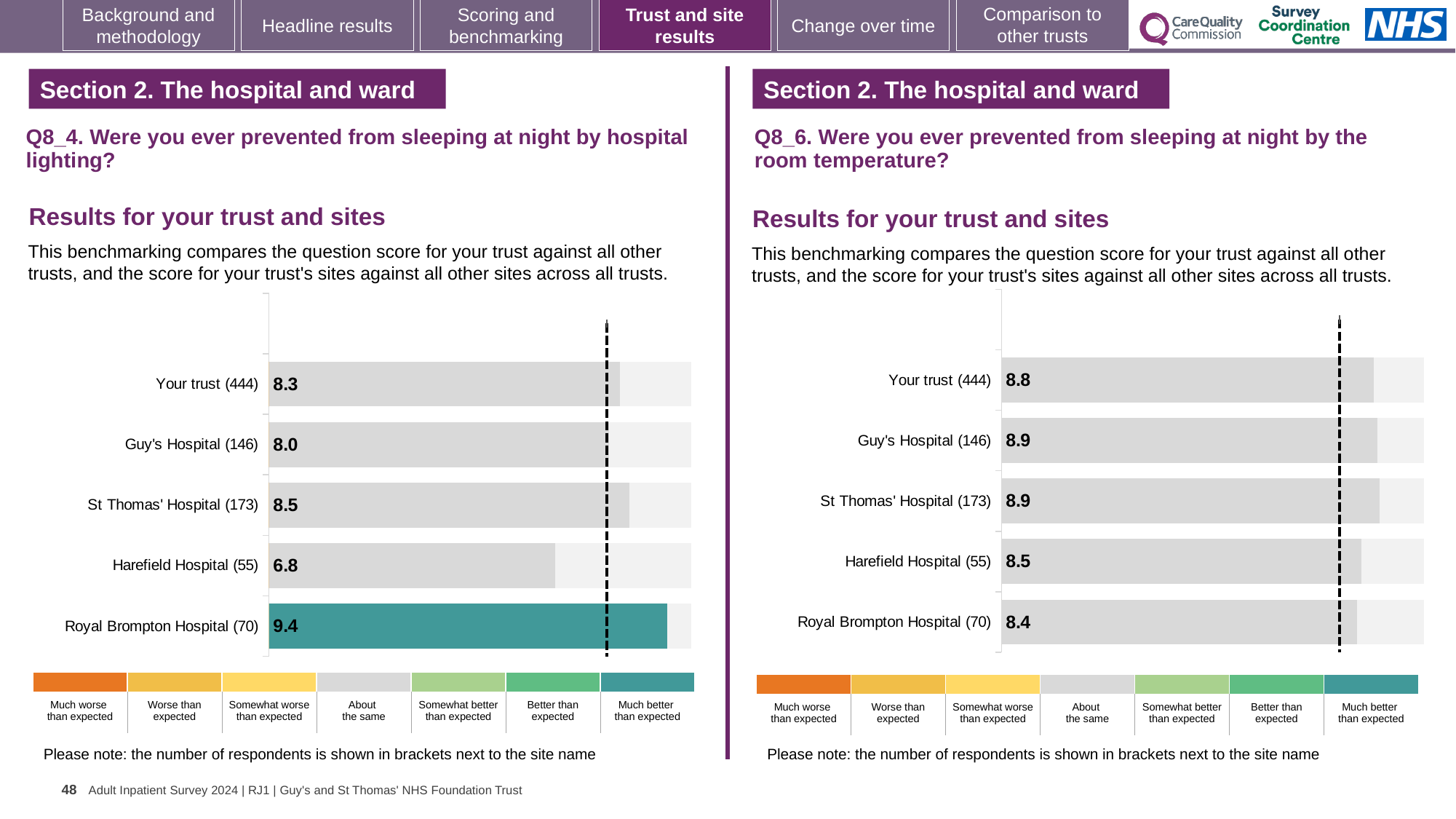
In the Q8_6 chart (room temperature), what is the score for Royal Brompton Hospital? 8.4 In the Q8_6 chart (room temperature), what is the difference between the scores for Guy's Hospital and Harefield Hospital? 0.4 In the Q8_6 chart (room temperature), what is the score for Your trust? 8.8 What kind of chart is used for the Q8_6 results (room temperature)? Bar chart In the Q8_6 chart (room temperature), which is larger: the score for Harefield Hospital or the score for Royal Brompton Hospital? Harefield Hospital In the Q8_6 chart (room temperature), which site has the lowest score? Royal Brompton Hospital In the Q8_4 chart (hospital lighting), which site or trust row has the highest score? Royal Brompton Hospital In the Q8_4 chart (hospital lighting), what is the score for Harefield Hospital? 6.8 In the Q8_4 chart (hospital lighting), what is the score for Royal Brompton Hospital? 9.4 In the Q8_4 chart (hospital lighting), which site or trust row has the lowest score? Harefield Hospital In the Q8_4 chart (hospital lighting), what is the difference between the scores for St Thomas' Hospital and Guy's Hospital? 0.5 How many rows (trust and sites) are plotted in the Q8_4 chart (hospital lighting)? 5